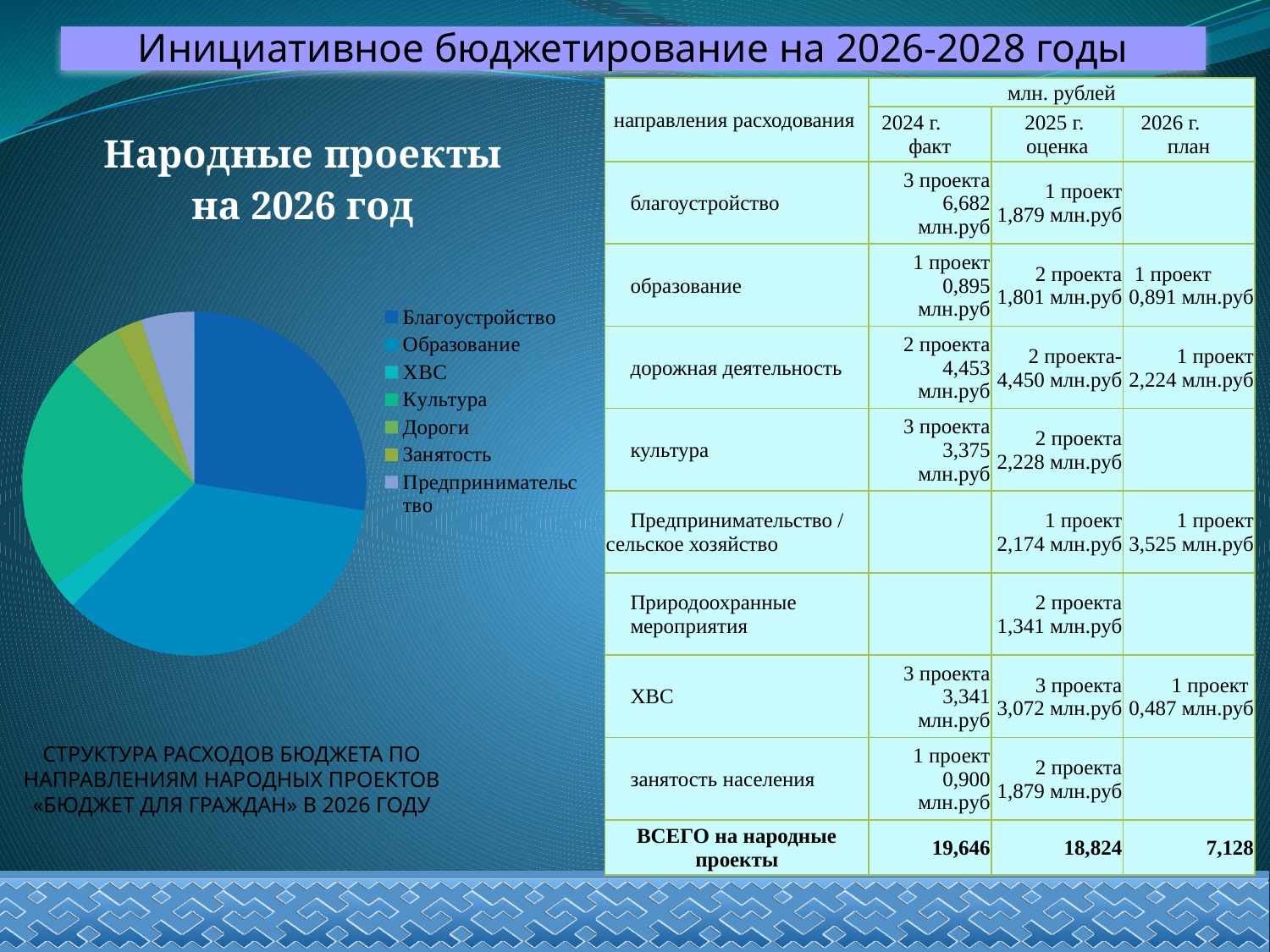
In the pie chart, which slice is larger: Благоустройство or ХВС? Благоустройство What is the title shown above the pie chart? Народные проекты на 2026 год How many categories does the pie chart's legend list? 7 In the pie chart, which slice is larger: Образование or Дороги? Образование In the pie chart, which slice is larger: Культура or Предпринимательство? Культура What kind of chart is shown on the left of the slide? pie chart Which legend entry is listed first in the pie chart's legend? Благоустройство